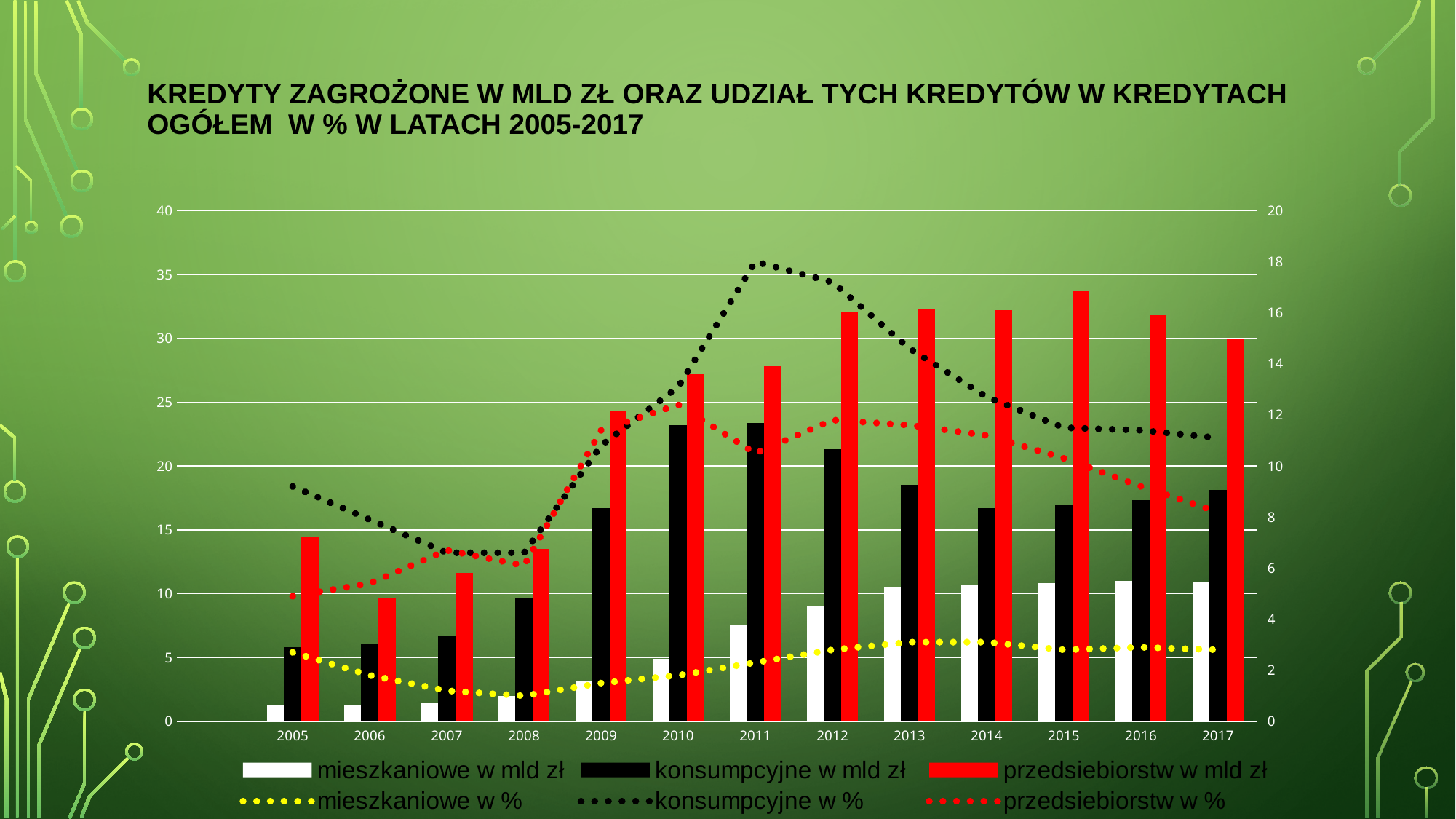
Is the value for 'konsumpcyjne w mld zł' in 2010 greater or less than 20? greater What kind of chart is shown on the slide? A combined bar and line chart In which year is the bar for 'przedsiebiorstw w mld zł' the lowest? 2006 How many series does the legend list? 6 What colour are the bars for 'przedsiebiorstw w mld zł'? Red How many years are shown on the x axis? 13 In 2005, which bar is larger: 'konsumpcyjne w mld zł' or 'przedsiebiorstw w mld zł'? przedsiebiorstw w mld zł In which year is the bar for 'przedsiebiorstw w mld zł' the highest? 2015 Is the value for 'mieszkaniowe w mld zł' in 2009 greater or less than 5? less Is the value for 'konsumpcyjne w %' in 2011 greater or less than 15 on the right axis? greater Do the 'mieszkaniowe w mld zł' bars generally rise or fall from 2005 to 2017? rise In which year does the 'konsumpcyjne w %' line reach its peak? 2011